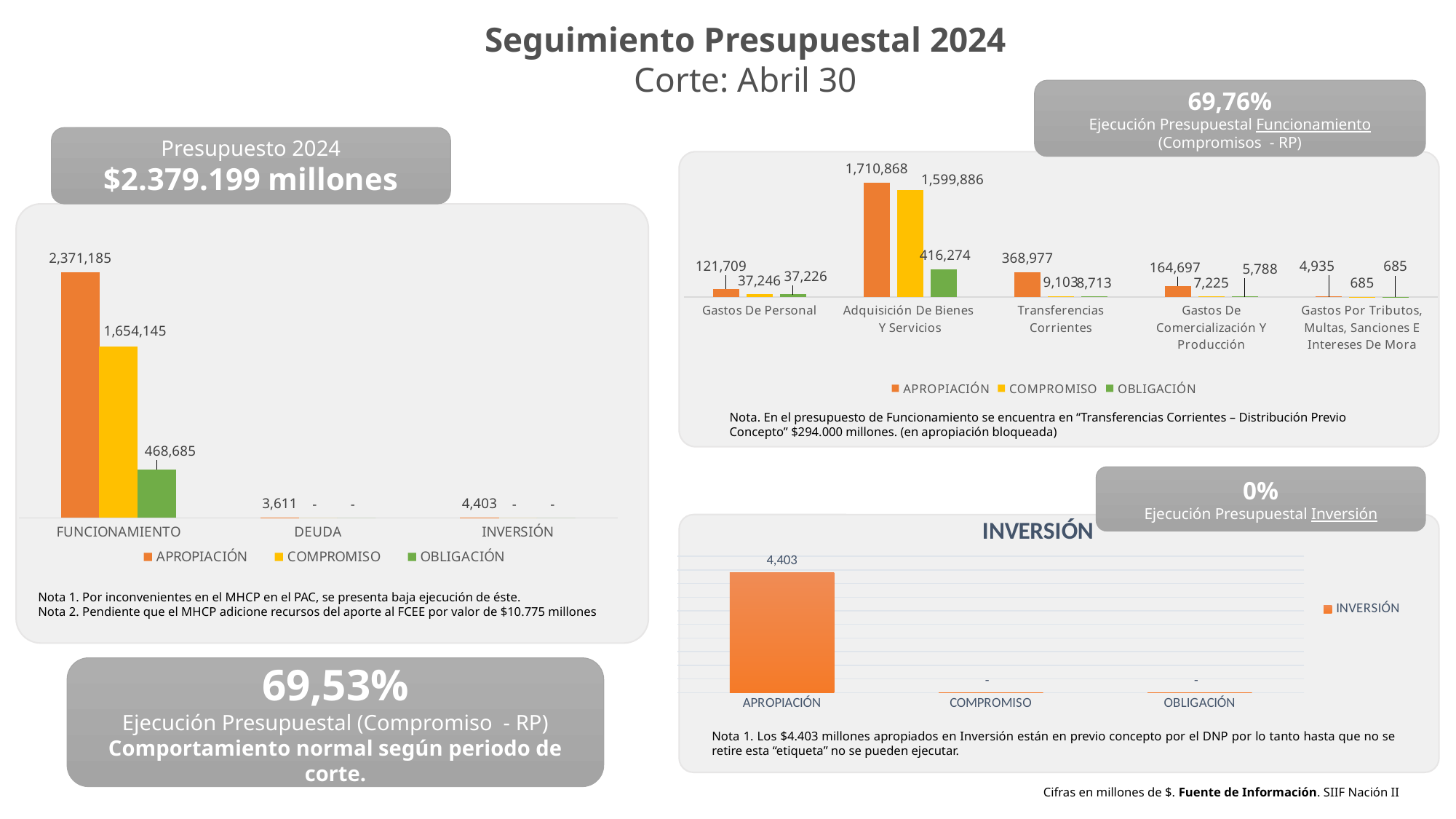
In the left chart (Presupuesto 2024), what is the APROPIACIÓN value for FUNCIONAMIENTO? 2,371,185 In the left chart (Presupuesto 2024), which category has the highest APROPIACIÓN value? FUNCIONAMIENTO In the top-right chart (Funcionamiento breakdown), which is larger: the APROPIACIÓN for Transferencias Corrientes or the APROPIACIÓN for Gastos De Comercialización Y Producción? Transferencias Corrientes In the left chart (Presupuesto 2024), what is the OBLIGACIÓN value for FUNCIONAMIENTO? 468,685 In the left chart (Presupuesto 2024), what is the difference between the APROPIACIÓN and COMPROMISO values for FUNCIONAMIENTO? 717,040 What type of chart is the bottom-right chart titled INVERSIÓN? bar chart In the top-right chart (Funcionamiento breakdown), how many categories are shown on the x axis? 5 In the left chart (Presupuesto 2024), how many series does the legend list? 3 In the top-right chart (Funcionamiento breakdown), which category has the lowest APROPIACIÓN value? Gastos Por Tributos, Multas, Sanciones E Intereses De Mora In the bottom-right chart titled INVERSIÓN, what is the APROPIACIÓN value? 4,403 In the top-right chart (Funcionamiento breakdown), what is the APROPIACIÓN value for Gastos De Personal? 121,709 In the top-right chart (Funcionamiento breakdown), what is the COMPROMISO value for Adquisición De Bienes Y Servicios? 1,599,886